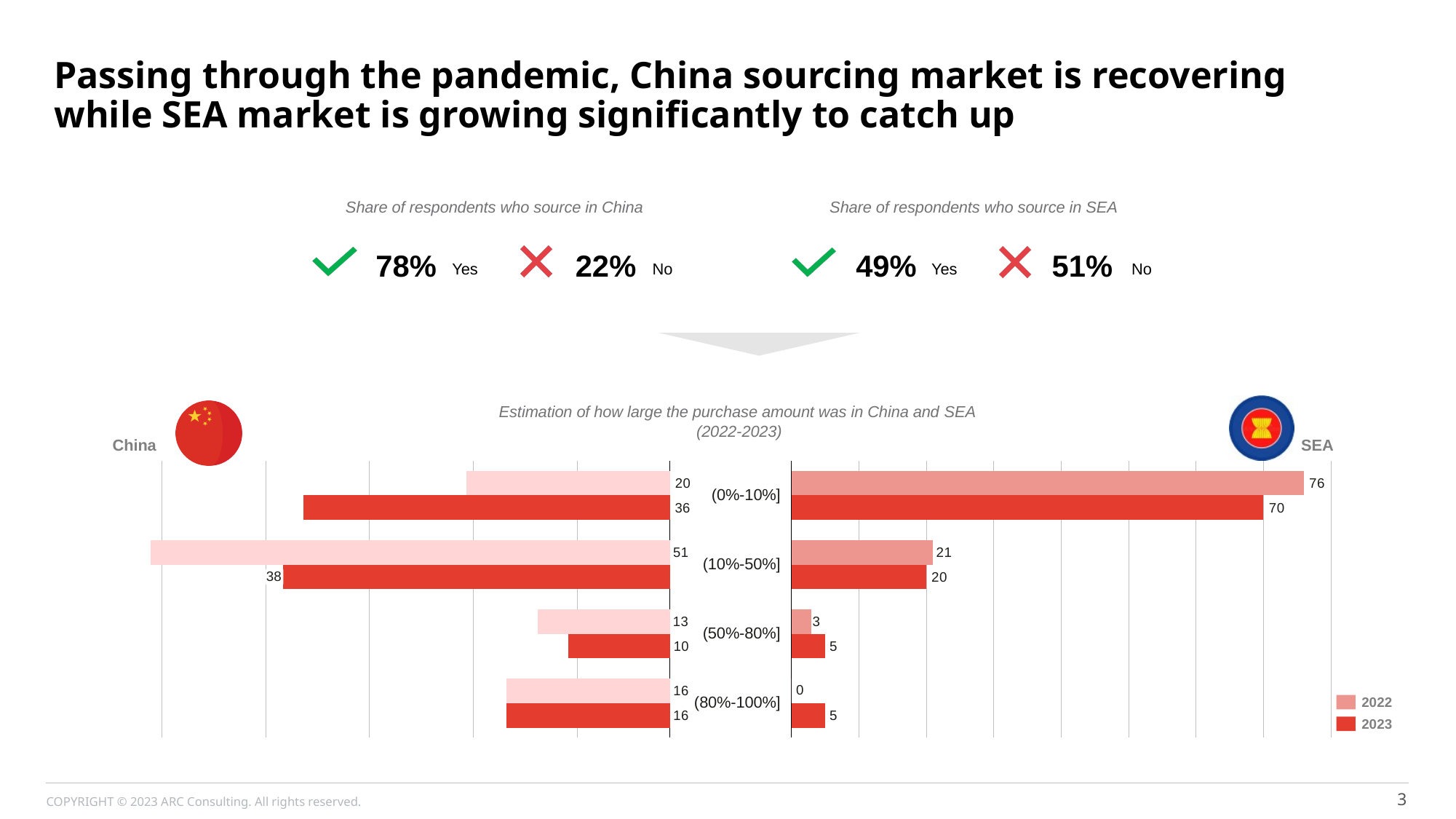
On the SEA side of the chart, what is the 2022 value for the (80%-100%] category? 0 On the SEA side of the chart, what is the 2022 value for the (0%-10%] category? 76 On the China side of the chart, what is the 2022 value for the (10%-50%] category? 51 On the China side of the chart, is the 2022 value or the 2023 value larger for the (0%-10%] category? 2023 On the SEA side of the chart, what is the difference between the 2022 and 2023 values for the (0%-10%] category? 6 On the China side of the chart, what is the difference between the 2022 and 2023 values for the (10%-50%] category? 13 On the China side of the chart, which category has the lowest 2023 value? (50%-80%] On the SEA side of the chart, which category has the highest 2023 value? (0%-10%] How many series does the chart legend list? 2 On the China side of the chart, what is the 2023 value for the (0%-10%] category? 36 How many purchase-amount categories are shown in the chart? 4 What type of chart is used to show the estimation of purchase amounts in China and SEA? Bar chart